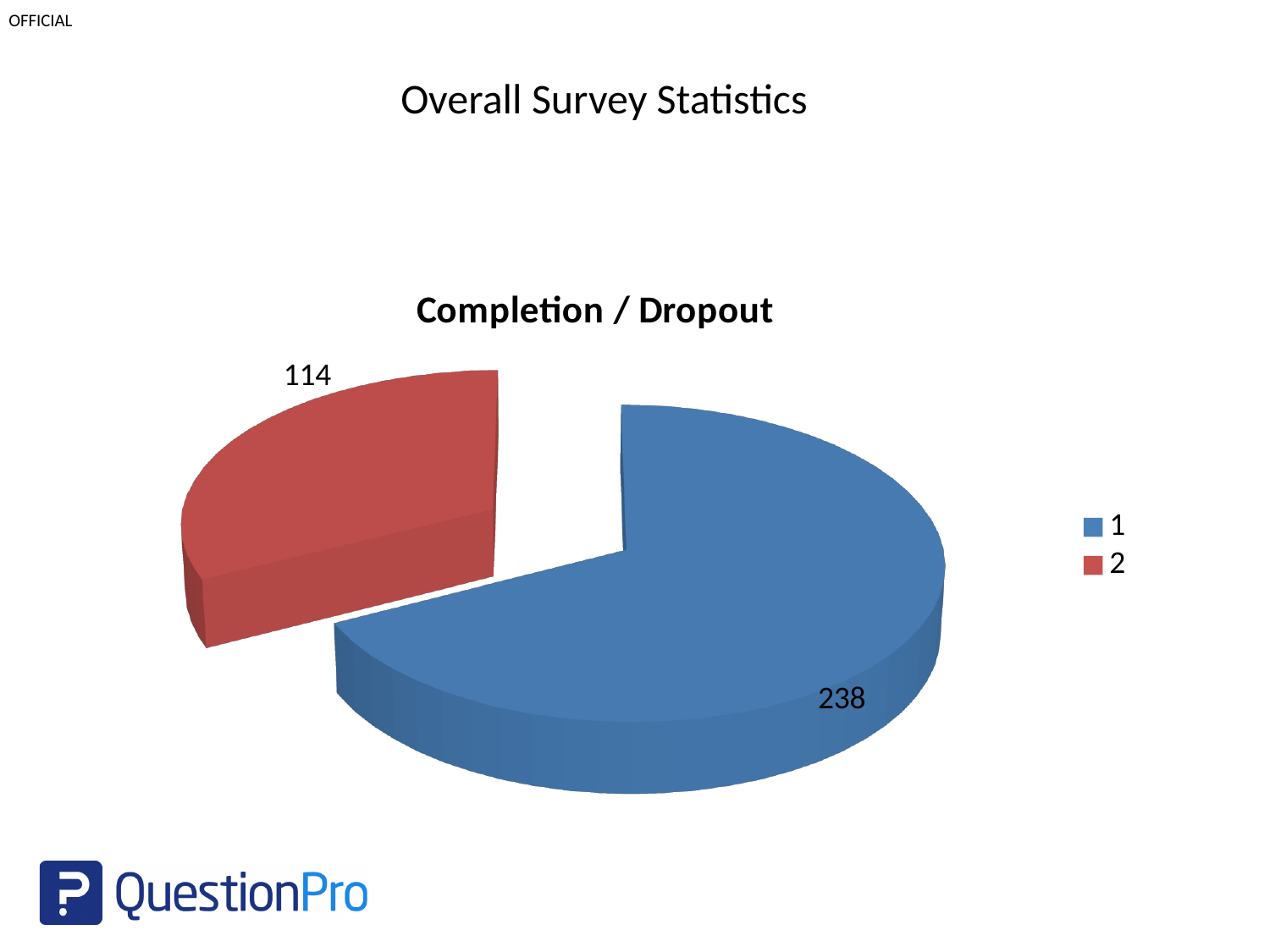
Which category has the largest slice? 1 How many slices does the pie chart have? 2 Which category has the smallest slice? 2 What is the title of the chart? Completion / Dropout How many entries does the legend list? 2 What kind of chart is shown on the slide? pie chart What is the value for category 1? 238 Which is larger, the value for category 1 or category 2? 1 What colour is the slice for category 2? red What is the difference between the values for category 1 and category 2? 124 What is the value for category 2? 114 What is the total of the two slices? 352